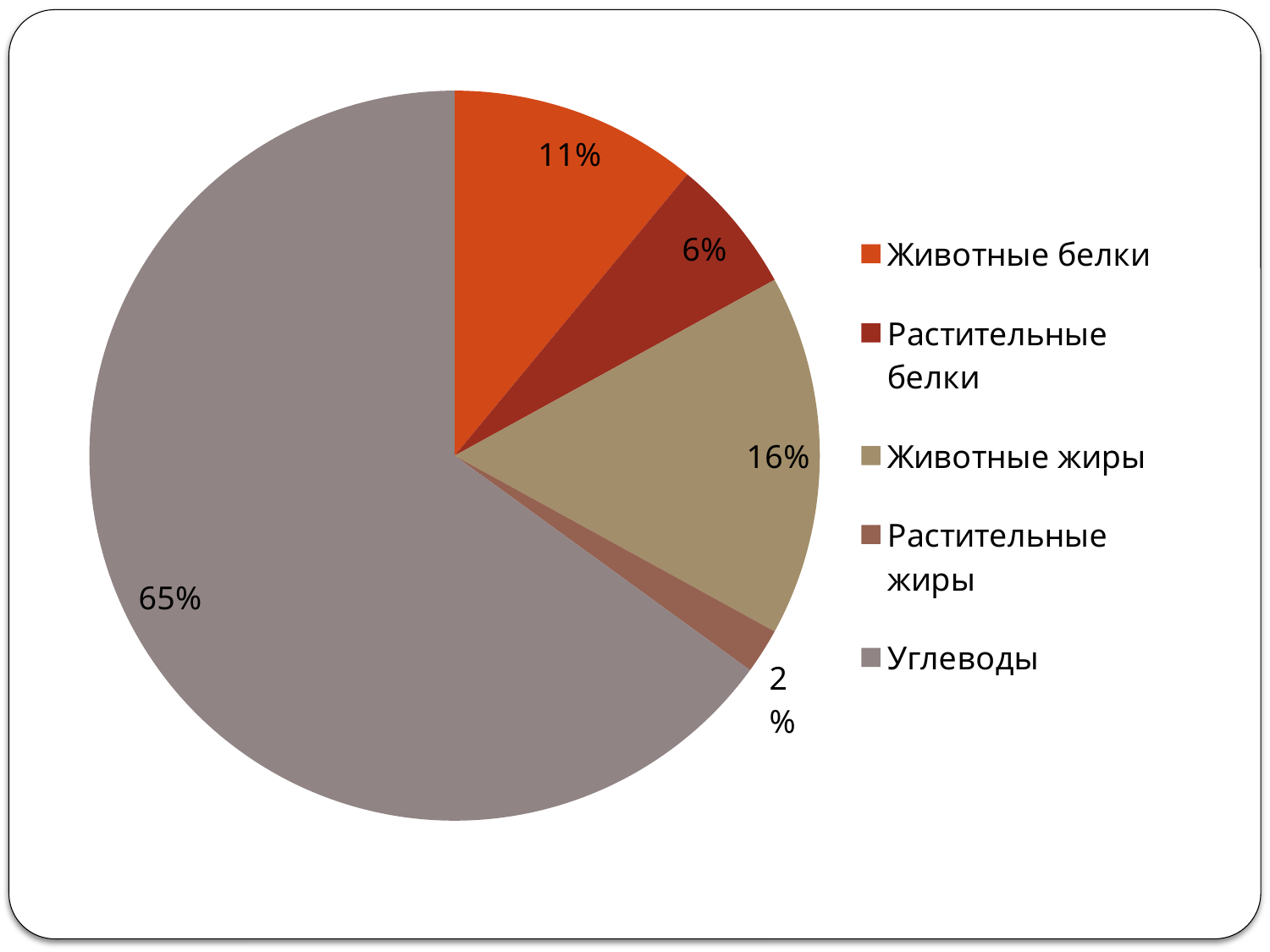
What is the value shown for Растительные белки? 6% Which category has the smallest slice of the pie? Растительные жиры Which is larger, the share of Животные белки or the share of Растительные белки? Животные белки What share of the pie does Углеводы take? 65% Which category has the largest slice of the pie? Углеводы What is the value shown for Животные жиры? 16% What is the value shown for Растительные жиры? 2% What is the value shown for Животные белки? 11% How many categories does the pie chart show? 5 What kind of chart is shown on the slide? Pie chart What colour is the slice for Углеводы? Grey What is the difference between the shares of Животные жиры and Животные белки? 5%